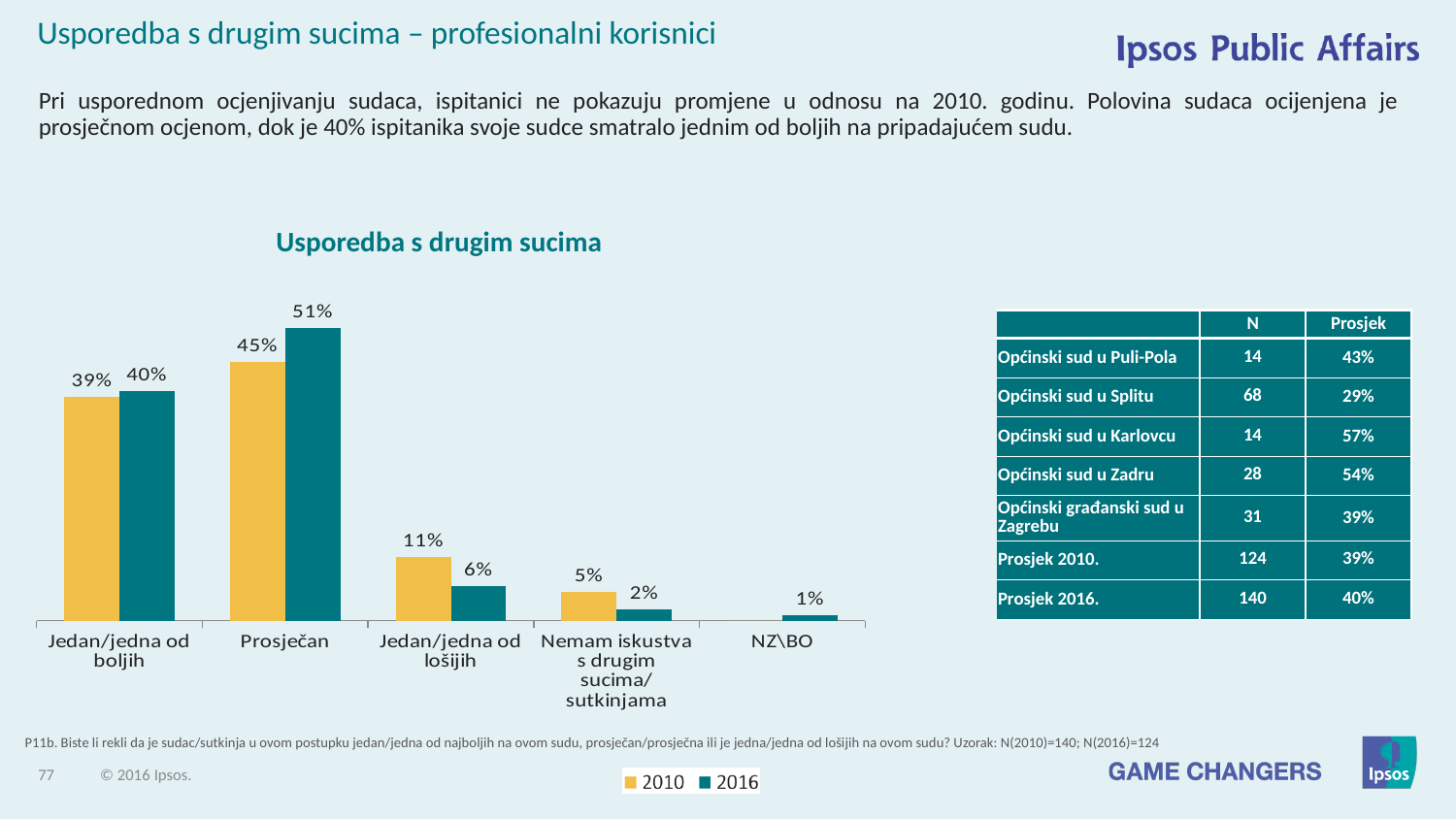
What is the difference between the 2010 and 2016 values for "Jedan/jedna od lošijih"? 5% Which category has the lowest 2016 value in the chart? NZ\BO What is the 2010 value for "Nemam iskustva s drugim sucima/sutkinjama" in the chart? 5% What is the difference between the 2016 and 2010 values for "Prosječan"? 6% How many categories are shown on the x axis of the chart? 5 What is the 2016 value for "Jedan/jedna od lošijih" in the chart? 6% Which category has the highest 2016 value in the chart? Prosječan For "Jedan/jedna od boljih", which year has the larger value, 2010 or 2016? 2016 How many series does the chart legend list? 2 What type of chart is "Usporedba s drugim sucima"? Bar chart What is the 2010 value for "Jedan/jedna od boljih" in the chart? 39% What is the 2016 value for "Prosječan" in the chart "Usporedba s drugim sucima"? 51%